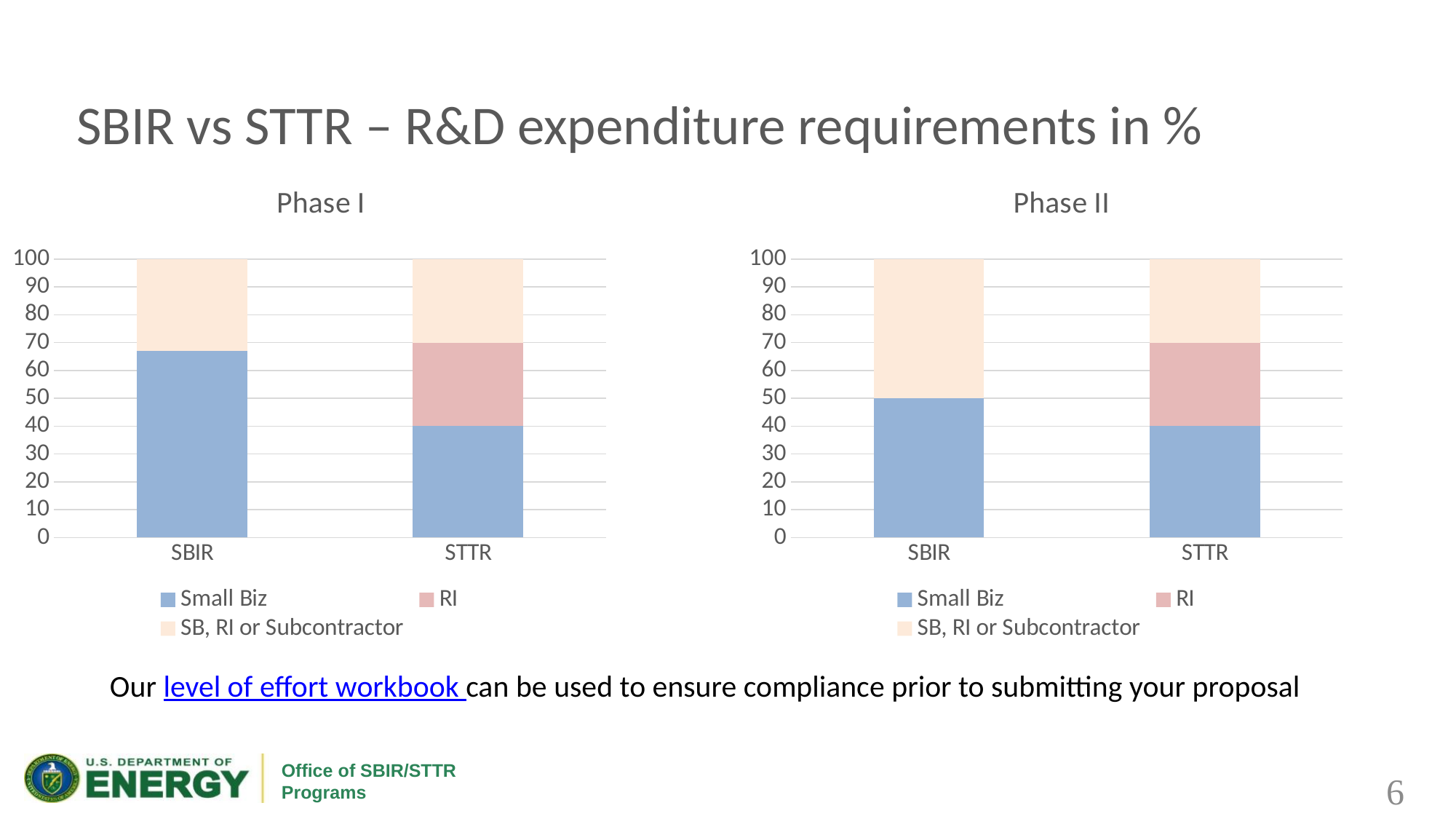
How many categories are shown on the x axis of the Phase I chart? 2 In the Phase II chart, what is the Small Biz value for SBIR? 50 In the Phase I chart, is the Small Biz value for SBIR greater or less than 60? greater In the Phase II chart, which category has the larger Small Biz value, SBIR or STTR? SBIR In the Phase II chart, what is the total height of the stacked bar for STTR? 100 What kind of chart is the Phase I chart? Stacked bar chart In the Phase II chart, what is the Small Biz value for STTR? 40 How many series does the legend of the Phase II chart list? 3 Which legend entry in the Phase I chart is shown in the lightest (peach) colour? SB, RI or Subcontractor In the Phase I chart, which category has the larger Small Biz value, SBIR or STTR? SBIR What is the title of the chart on the right side of the slide? Phase II In the Phase I chart, what is the Small Biz value for STTR? 40